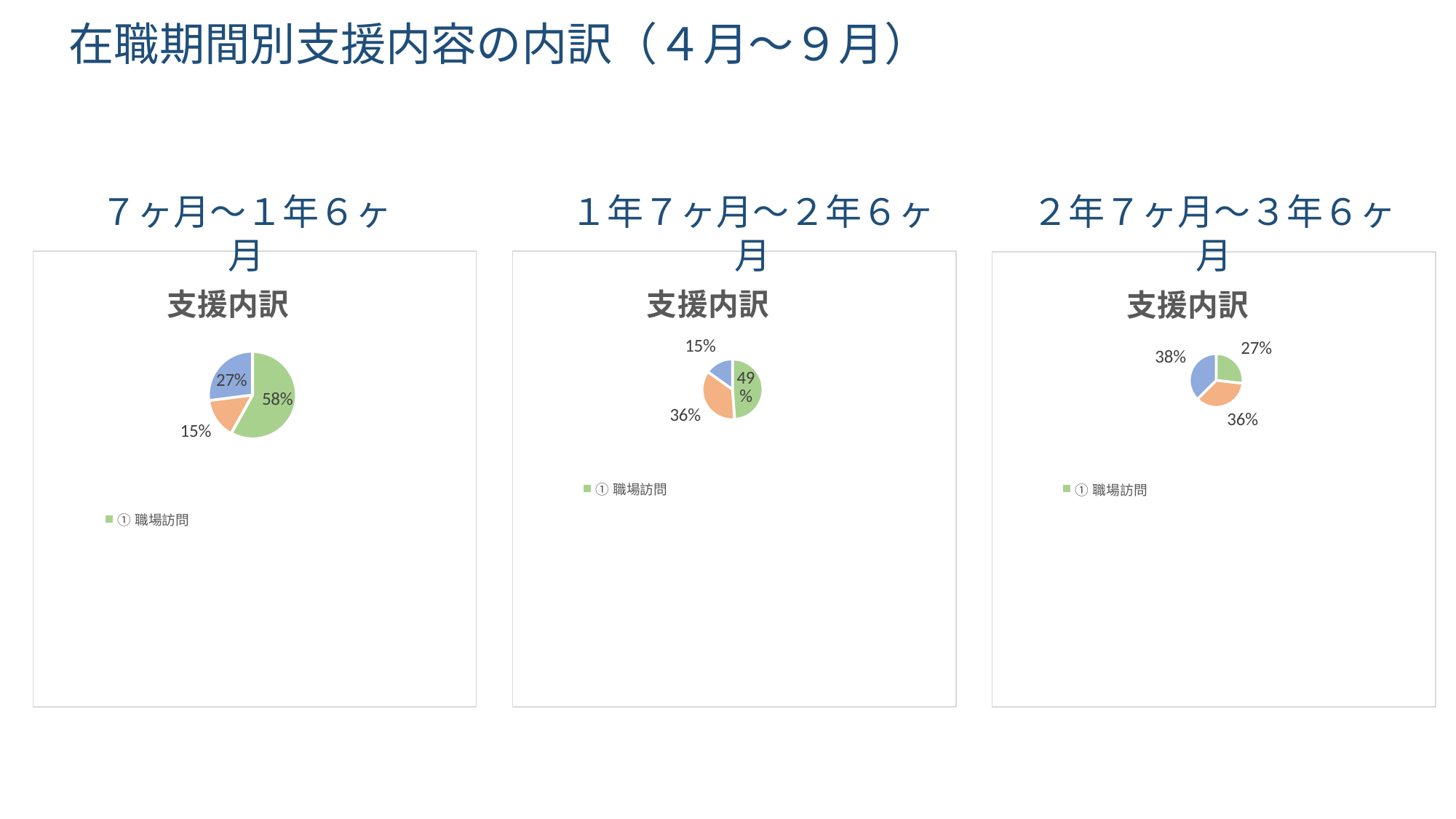
In the right chart (2年7ヶ月〜3年6ヶ月), what share does ① 職場訪問 have? 27% What kind of chart is shown in the left chart (7ヶ月〜1年6ヶ月)? pie chart Which chart has the larger share for ① 職場訪問: the left chart (7ヶ月〜1年6ヶ月) or the right chart (2年7ヶ月〜3年6ヶ月)? the left chart (7ヶ月〜1年6ヶ月) In the left chart (7ヶ月〜1年6ヶ月), what is the largest slice's percentage? 58% In the left chart (7ヶ月〜1年6ヶ月), what is the difference between the largest slice (58%) and the smallest slice (15%)? 43% In the middle chart (1年7ヶ月〜2年6ヶ月), what is the smallest slice's percentage? 15% In the right chart (2年7ヶ月〜3年6ヶ月), what is the difference between the 38% slice and the 27% slice? 11% In the left chart (7ヶ月〜1年6ヶ月), what share does ① 職場訪問 have? 58% How many slices does the pie in the middle chart (1年7ヶ月〜2年6ヶ月) have? 3 In the middle chart (1年7ヶ月〜2年6ヶ月), what share does ① 職場訪問 have? 49% In the left chart (7ヶ月〜1年6ヶ月), what is the smallest slice's percentage? 15% What is the title shown inside each of the three charts? 支援内訳